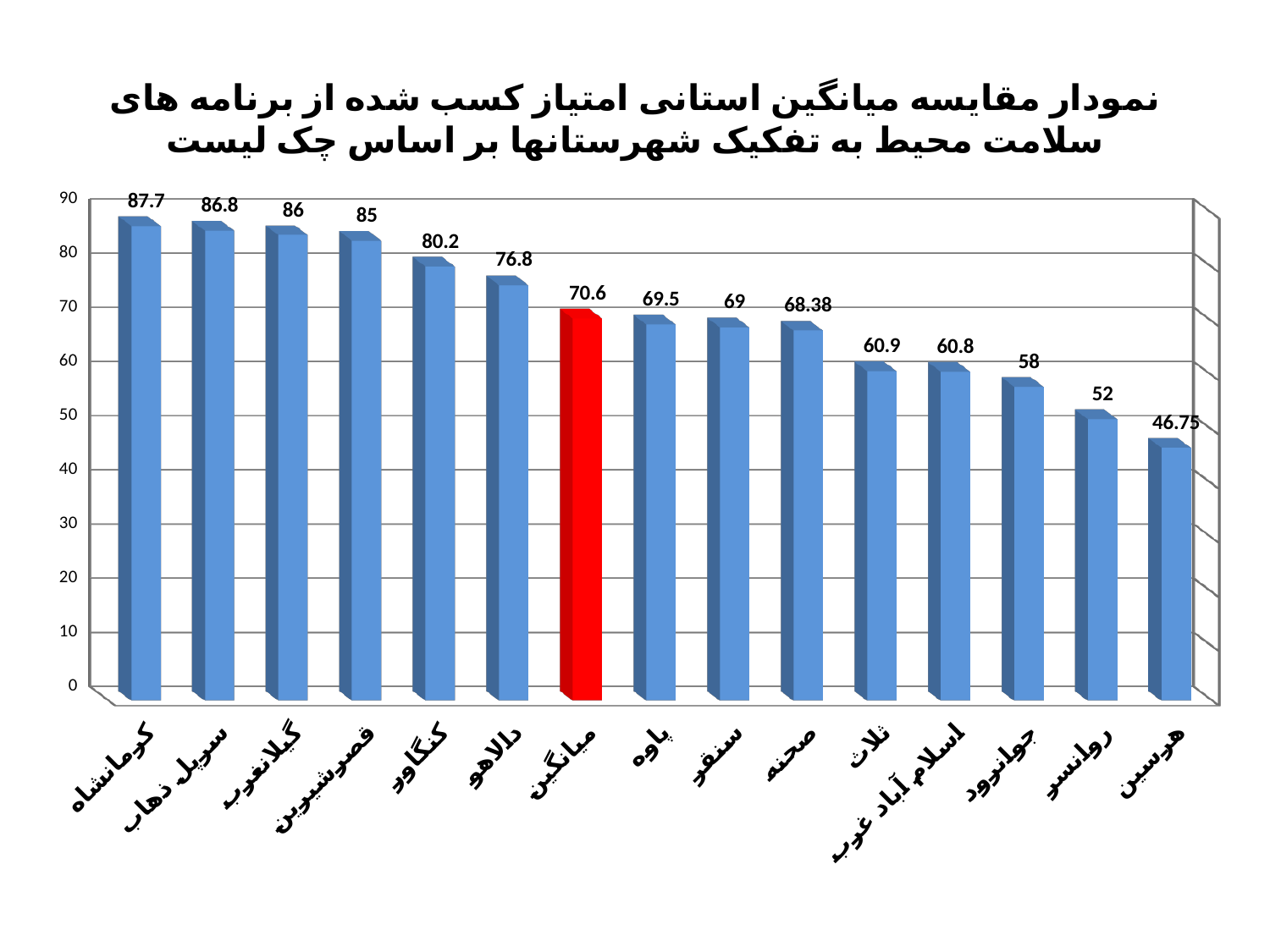
Which category has the highest value? کرمانشاه What is the difference between the values for کرمانشاه and هرسین? 40.95 Which bar is coloured red instead of blue? میانگین What is the difference between the values for کنگاور and دالاهو? 3.4 What is the value for هرسین? 46.75 What is the value for صحنه? 68.38 What is the value of the red bar labelled میانگین? 70.6 What is the value for کرمانشاه? 87.7 What kind of chart is shown on the slide? Bar chart Which is larger, the value for پاوه or the value for جوانرود? پاوه How many bars are shown in the chart? 15 Which category has the lowest value? هرسین